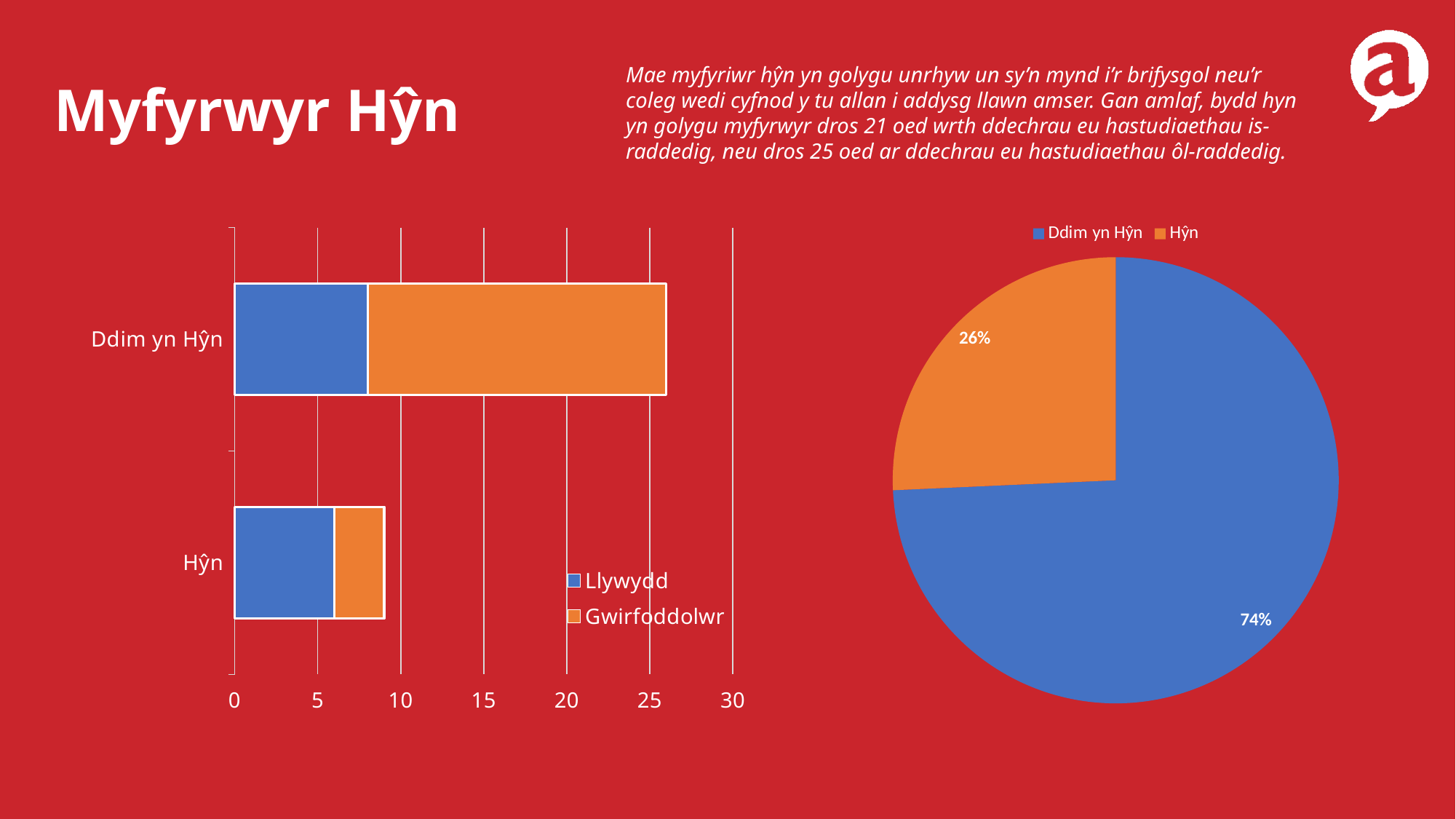
On the pie chart, what share is shown for Hŷn? 26% On the bar chart on the left, how many series does the legend list? 2 On the bar chart on the left, is the total value for Ddim yn Hŷn greater or less than 20? greater On the pie chart, what share is shown for Ddim yn Hŷn? 74% What kind of chart is the chart on the right of the slide? Pie chart On the pie chart, which slice is the largest? Ddim yn Hŷn On the pie chart, what is the difference in percentage points between the Ddim yn Hŷn slice and the Hŷn slice? 48 percentage points What kind of chart is the chart on the left of the slide? Bar chart On the pie chart, how many slices are there? 2 On the bar chart on the left, which category has the longer total bar, Ddim yn Hŷn or Hŷn? Ddim yn Hŷn On the bar chart on the left, is the total value for Hŷn greater or less than 10? less On the bar chart on the left, which series is shown in orange? Gwirfoddolwr